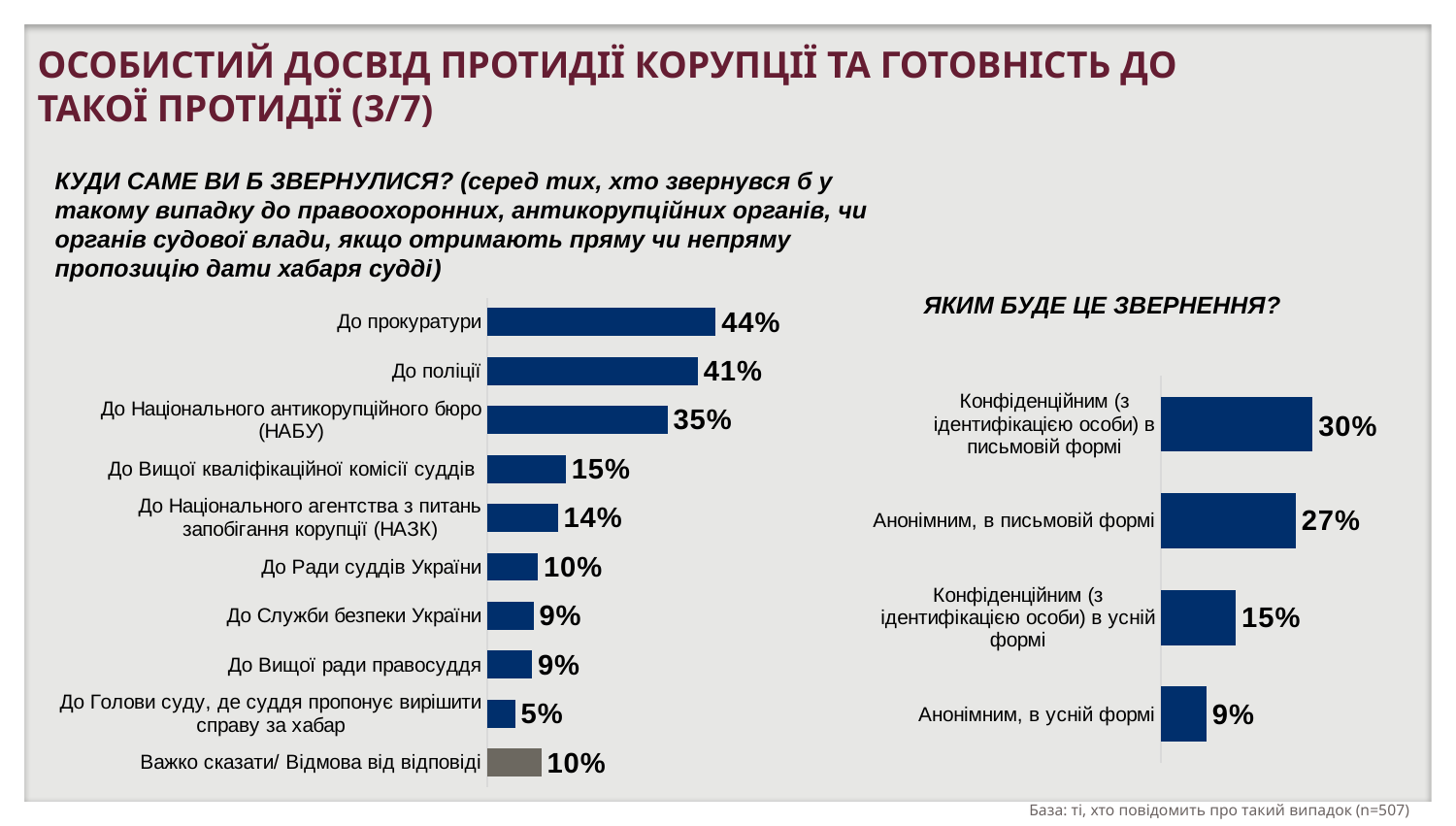
In the left chart (КУДИ САМЕ ВИ Б ЗВЕРНУЛИСЯ?), how many categories are shown? 10 What type of chart is the right chart (ЯКИМ БУДЕ ЦЕ ЗВЕРНЕННЯ?)? Bar chart In the right chart (ЯКИМ БУДЕ ЦЕ ЗВЕРНЕННЯ?), what is the value for "Анонімним, в письмовій формі"? 27% In the right chart (ЯКИМ БУДЕ ЦЕ ЗВЕРНЕННЯ?), how many categories are shown? 4 In the left chart (КУДИ САМЕ ВИ Б ЗВЕРНУЛИСЯ?), which category has the lowest value? До Голови суду, де суддя пропонує вирішити справу за хабар In the left chart (КУДИ САМЕ ВИ Б ЗВЕРНУЛИСЯ?), which category has the highest value? До прокуратури In the left chart (КУДИ САМЕ ВИ Б ЗВЕРНУЛИСЯ?), what is the value for "До Національного антикорупційного бюро (НАБУ)"? 35% In the left chart (КУДИ САМЕ ВИ Б ЗВЕРНУЛИСЯ?), what is the value for "До прокуратури"? 44% In the left chart (КУДИ САМЕ ВИ Б ЗВЕРНУЛИСЯ?), what is the difference between "До прокуратури" and "До поліції"? 3% In the right chart (ЯКИМ БУДЕ ЦЕ ЗВЕРНЕННЯ?), what is the difference between "Конфіденційним (з ідентифікацією особи) в усній формі" and "Анонімним, в усній формі"? 6% In the left chart (КУДИ САМЕ ВИ Б ЗВЕРНУЛИСЯ?), which is larger: "До Вищої кваліфікаційної комісії суддів" or "До Ради суддів України"? До Вищої кваліфікаційної комісії суддів In the right chart (ЯКИМ БУДЕ ЦЕ ЗВЕРНЕННЯ?), which category has the highest value? Конфіденційним (з ідентифікацією особи) в письмовій формі